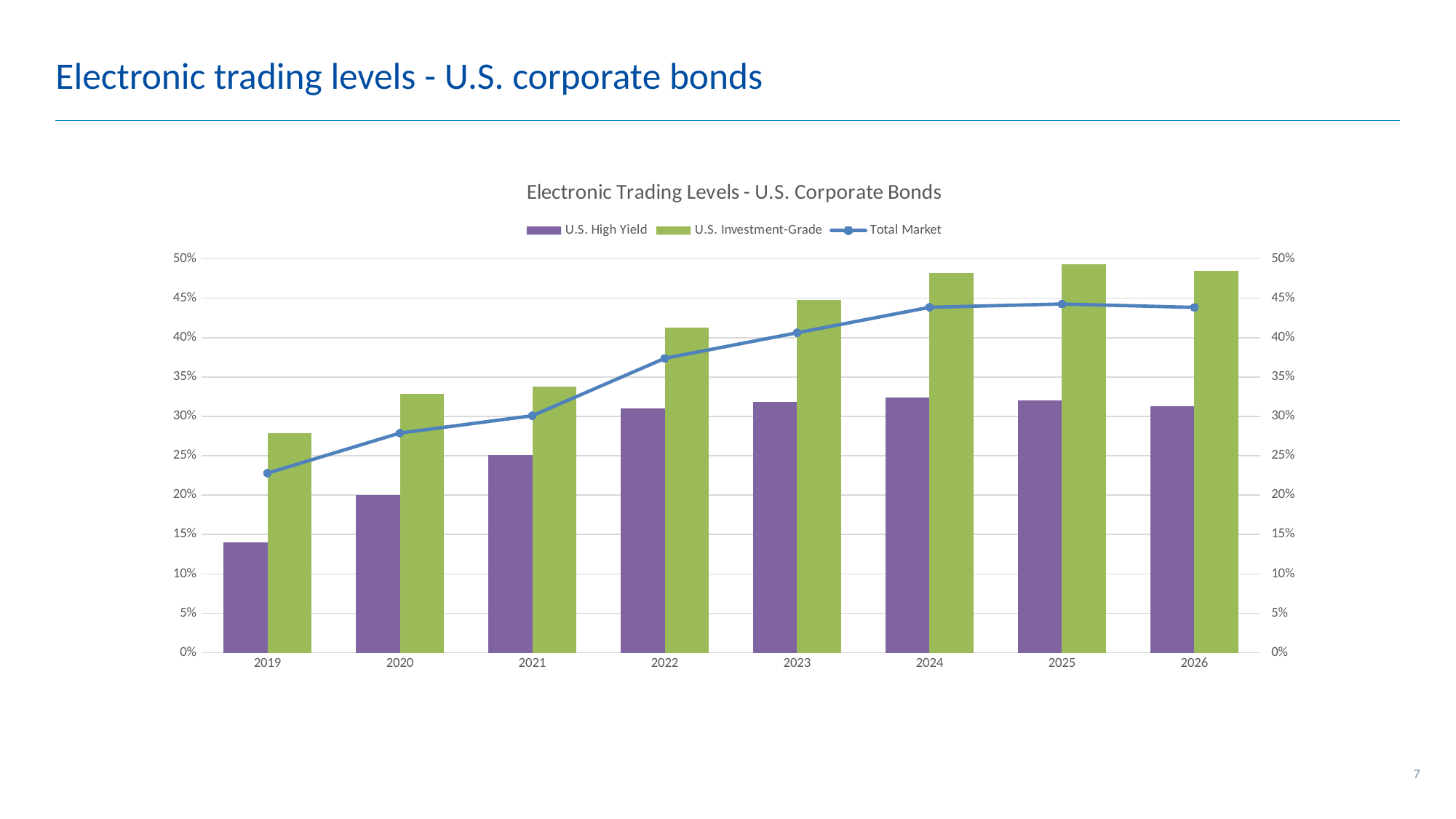
Which year has the highest value for U.S. Investment-Grade? 2025 In 2019, which is larger: U.S. High Yield or U.S. Investment-Grade? U.S. Investment-Grade How many series does the legend list? 3 Is the Total Market value in 2023 greater or less than 40%? greater What is the title of the chart? Electronic Trading Levels - U.S. Corporate Bonds Is the value for U.S. High Yield in 2019 greater or less than 15%? less How many years are shown on the x axis? 8 What kind of chart is shown on the slide? A combined bar and line chart Is the value for U.S. Investment-Grade in 2022 greater or less than 40%? greater Does the Total Market line generally rise or fall from 2019 to 2024? rise Which year has the lowest value for U.S. High Yield? 2019